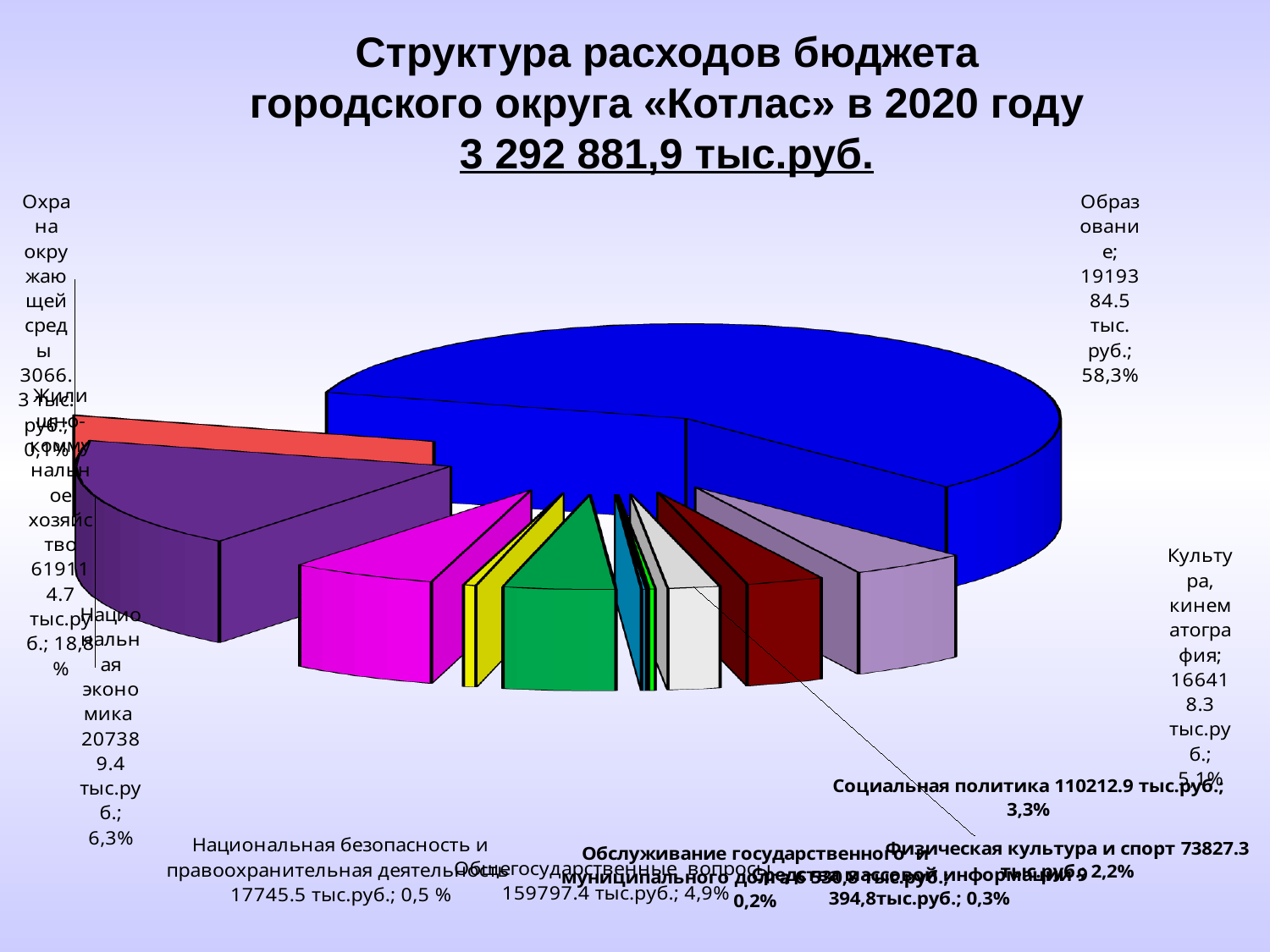
Which category has the smallest percentage share? Охрана окружающей среды Which category has the largest share of the budget expenditure? Образование What is the difference in percentage points between the shares of Образование and Жилищно-коммунальное хозяйство? 39,5 What percentage share does Образование have? 58,3% What total budget expenditure amount is stated in the chart title? 3 292 881,9 тыс.руб. What is the amount shown for Социальная политика? 110212.9 тыс.руб. What is the amount shown for Жилищно-коммунальное хозяйство? 619114.7 тыс.руб. What percentage share does Культура, кинематография have? 5,1% What percentage share does Физическая культура и спорт have? 2,2% How many expenditure categories are shown in the pie chart? 11 Which has a larger share: Национальная экономика or Общегосударственные вопросы? Национальная экономика What kind of chart is shown on the slide? pie chart